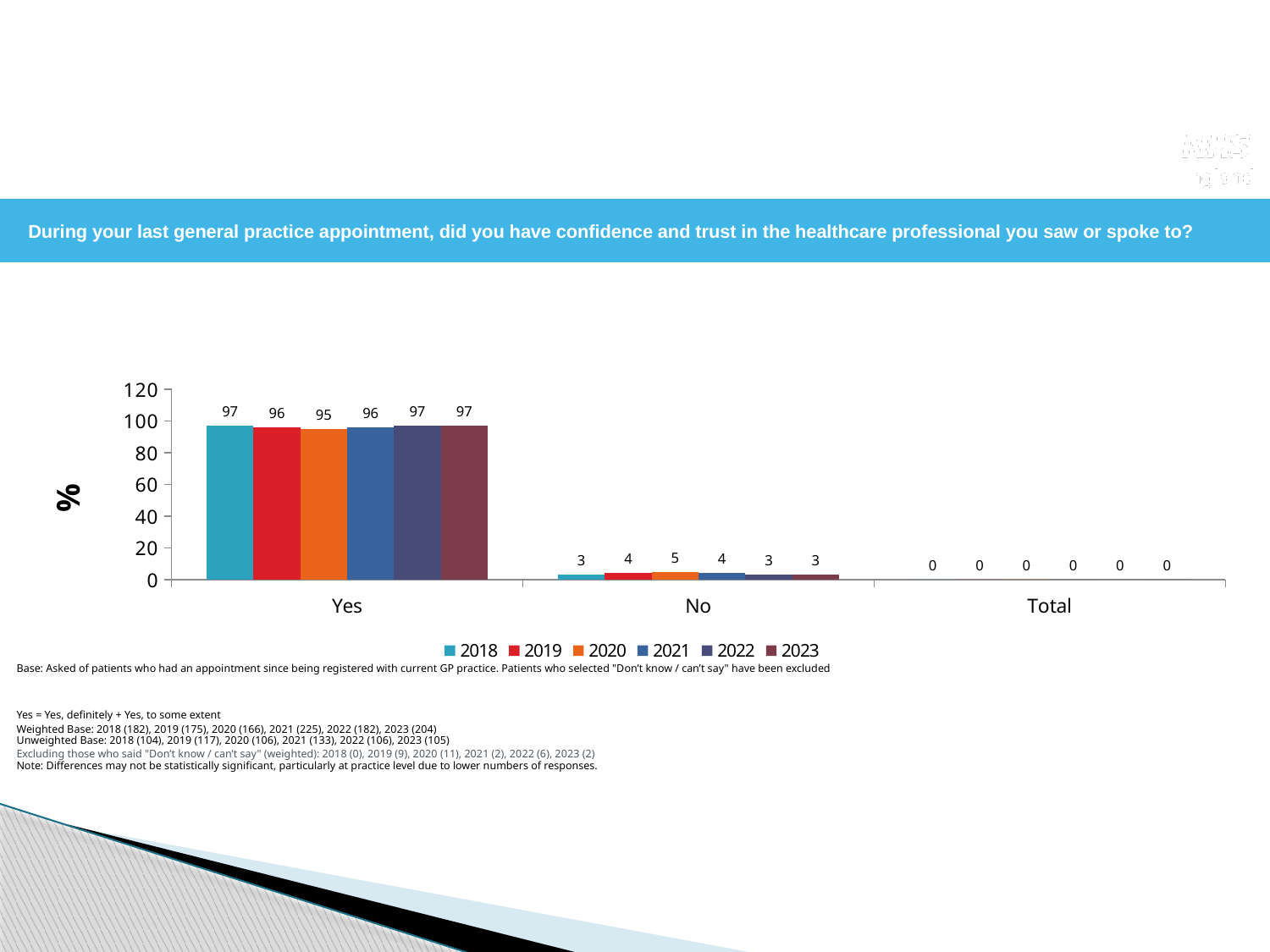
What is the difference between the 2020 No value and the 2023 No value? 2 What is the value for 2023 in the Yes category? 97 What kind of chart is shown on the slide? bar chart How many categories are shown on the x axis? 3 Which year has the lowest value in the Yes category? 2020 Which year has the highest value in the No category? 2020 What is the difference between the 2018 Yes value and the 2018 No value? 94 What is the value for 2019 in the No category? 4 What is the value shown for every year in the Total category? 0 Is the 2021 Yes value greater or less than 80? greater How many series does the legend list? 6 What is the value for 2020 in the Yes category? 95